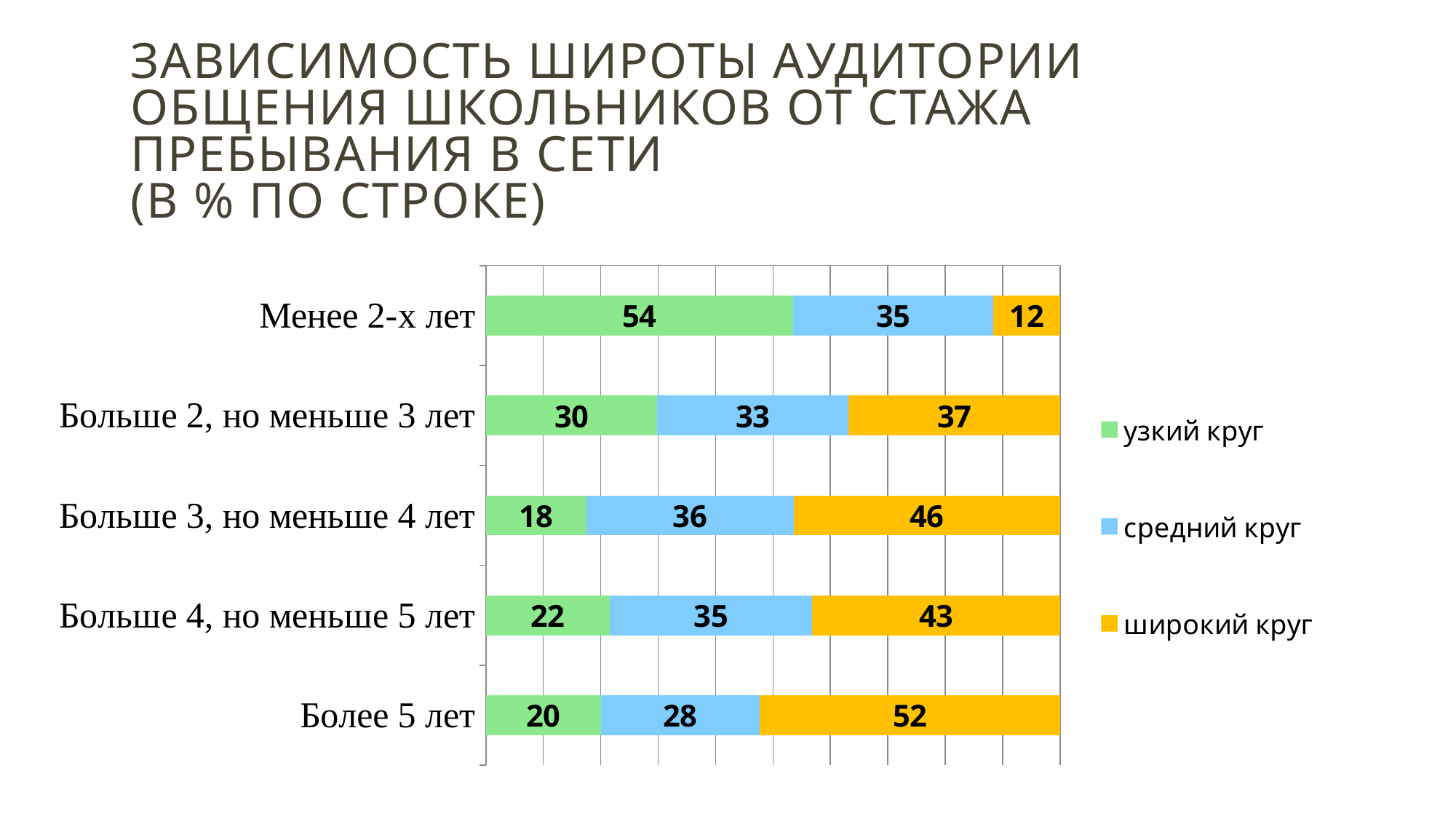
What is the total of the stacked bar for 'Больше 2, но меньше 3 лет'? 100 How many categories (age-of-experience groups) are shown on the chart? 5 What is the difference between the 'широкий круг' values for 'Более 5 лет' and 'Менее 2-х лет'? 40 Which category has the lowest value for 'широкий круг'? Менее 2-х лет What is the value of 'широкий круг' for 'Больше 3, но меньше 4 лет'? 46 How many series does the legend list? 3 What colour represents 'широкий круг' in the legend? Orange Which is larger: the 'средний круг' value for 'Больше 3, но меньше 4 лет' or for 'Более 5 лет'? Больше 3, но меньше 4 лет Which category has the highest value for 'узкий круг'? Менее 2-х лет What type of chart is shown on the slide? Stacked bar chart What is the value of 'средний круг' for 'Более 5 лет'? 28 What is the value of 'узкий круг' for 'Менее 2-х лет'? 54